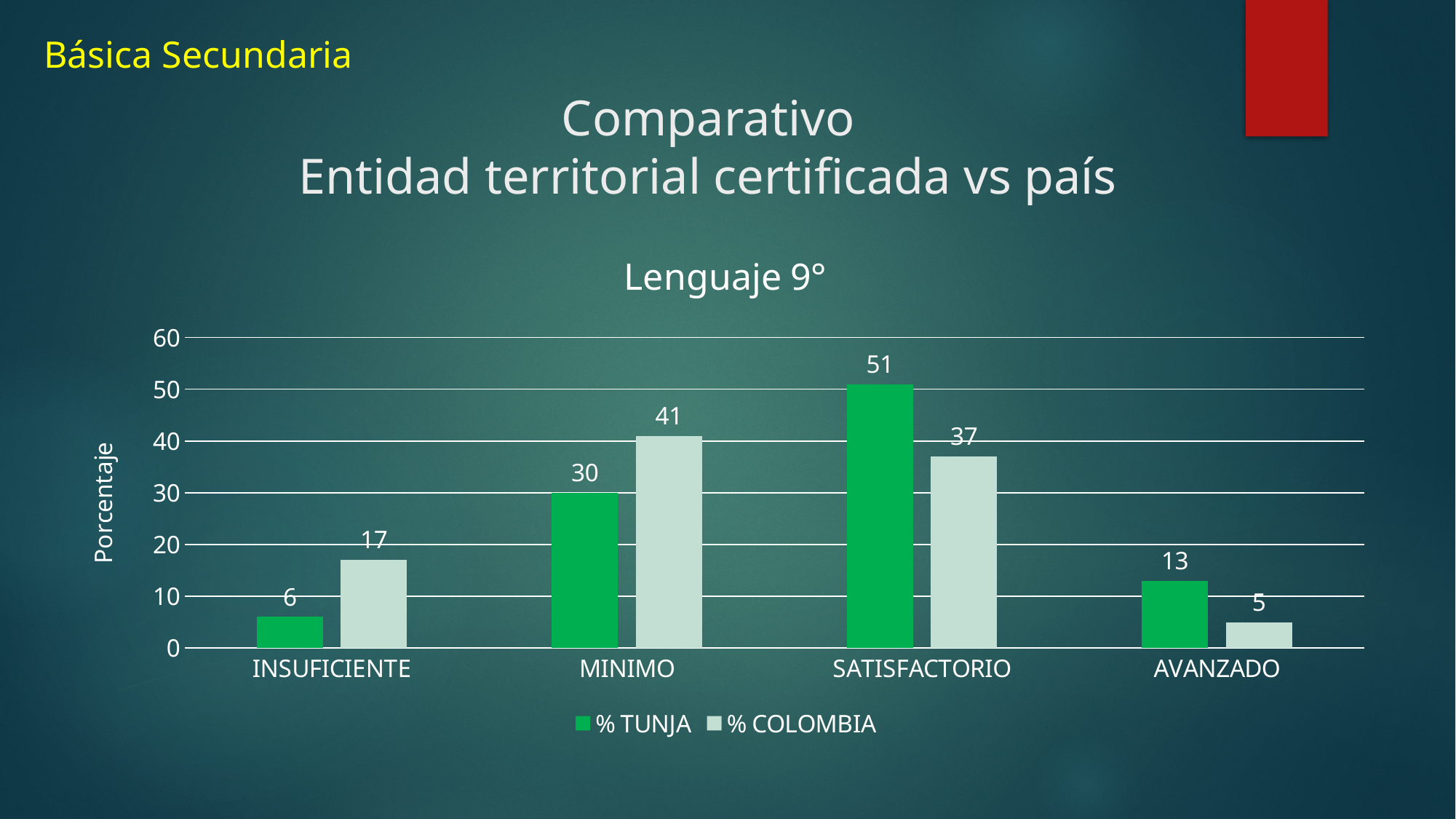
What is the title of the chart? Lenguaje 9° What kind of chart is shown? Bar chart What is the % COLOMBIA value for AVANZADO? 5 What is the % TUNJA value for INSUFICIENTE? 6 Which is larger for MINIMO, % TUNJA or % COLOMBIA? % COLOMBIA What is the % TUNJA value for SATISFACTORIO? 51 How many series does the legend list? 2 Which category has the highest % TUNJA value? SATISFACTORIO What is the % COLOMBIA value for MINIMO? 41 Which category has the lowest % COLOMBIA value? AVANZADO What is the difference between the % TUNJA and % COLOMBIA values for SATISFACTORIO? 14 How many categories are shown on the x axis? 4